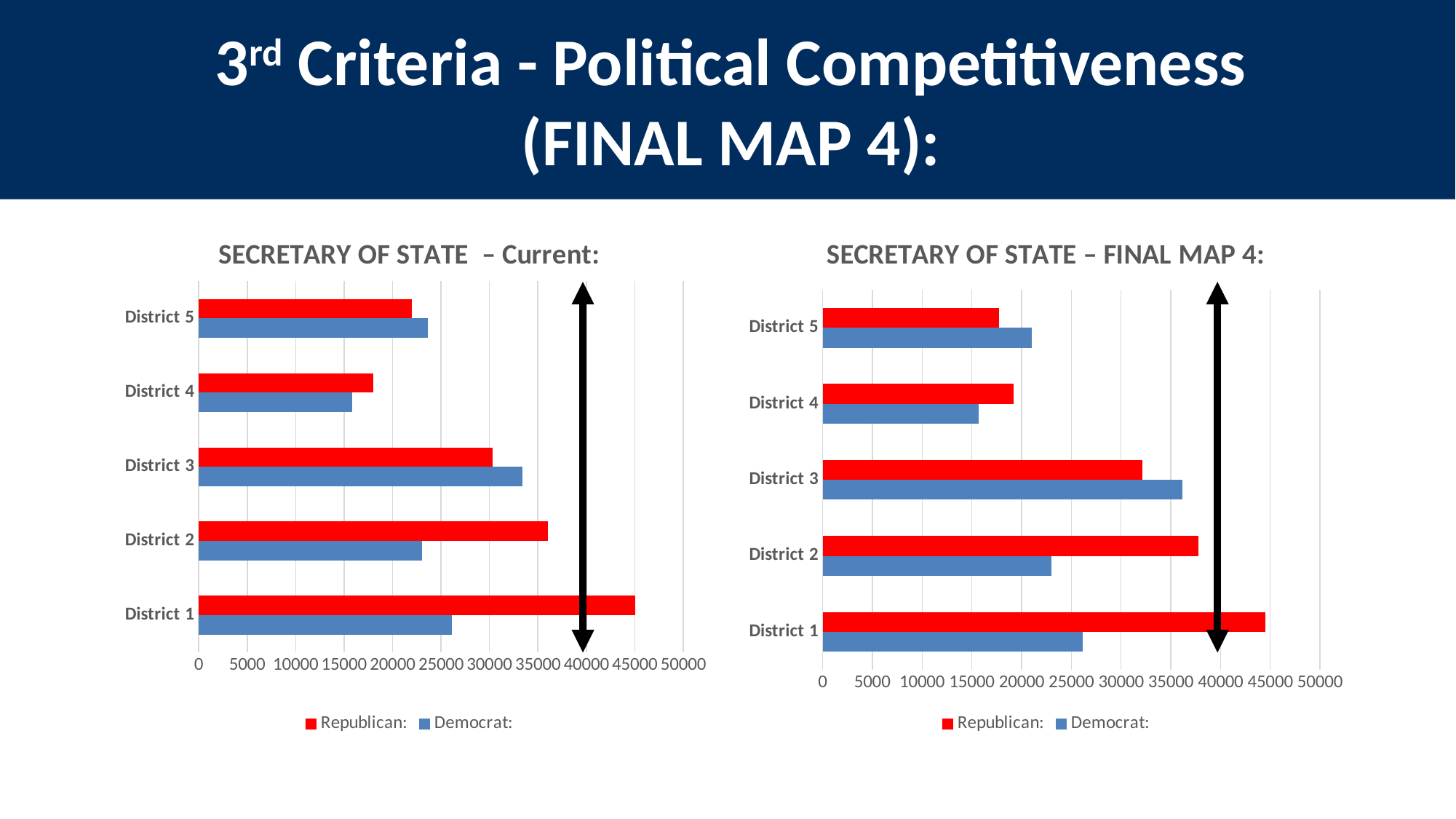
In the "SECRETARY OF STATE – Current:" chart, is the Republican value for District 1 greater or less than 40000? greater In the "SECRETARY OF STATE – FINAL MAP 4:" chart, is the Republican value for District 2 greater or less than 35000? greater How many districts are shown in the "SECRETARY OF STATE – Current:" chart? 5 How many series does the legend of the "SECRETARY OF STATE – Current:" chart list? 2 In the "SECRETARY OF STATE – Current:" chart, which is larger for District 2, the Republican or the Democrat value? Republican In the "SECRETARY OF STATE – FINAL MAP 4:" chart, which district has the lowest Democrat value? District 4 In the "SECRETARY OF STATE – Current:" chart, which district has the lowest Republican value? District 4 In the "SECRETARY OF STATE – FINAL MAP 4:" chart, which district has the highest Democrat value? District 3 In the "SECRETARY OF STATE – Current:" chart, is the Democrat value for District 4 greater or less than 20000? less In the "SECRETARY OF STATE – FINAL MAP 4:" chart, which is larger for District 3, the Republican or the Democrat value? Democrat In the "SECRETARY OF STATE – Current:" chart, which district has the highest Republican value? District 1 What kind of chart is the "SECRETARY OF STATE – Current:" chart? bar chart